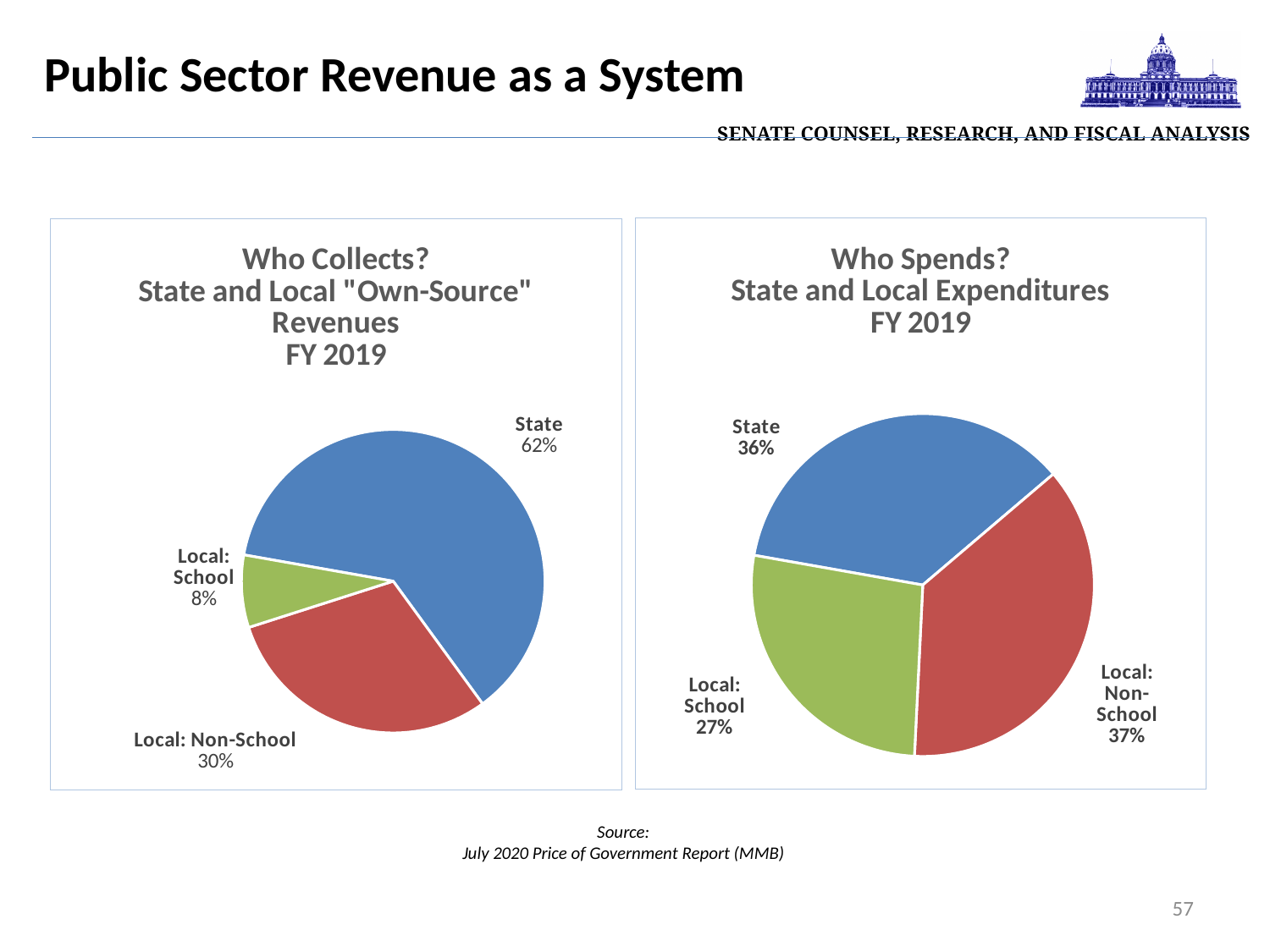
In the 'Who Collects?' pie chart, what share of revenues is collected by Local: Non-School? 30% What type of chart is used on the left side of the slide? pie chart In the 'Who Spends?' pie chart, what share of expenditures is spent by Local: Non-School? 37% In the 'Who Spends?' pie chart, what share of expenditures is spent by Local: School? 27% In the 'Who Spends?' pie chart, is the State share larger or smaller than the Local: School share? larger In the 'Who Collects?' pie chart, which category has the largest share? State In the 'Who Spends?' pie chart, which category has the smallest share? Local: School How many slices does the 'Who Spends?' pie chart have? 3 In the 'Who Collects?' pie chart, what share of revenues is collected by Local: School? 8% In the 'Who Collects?' pie chart, what share of revenues is collected by the State? 62% In the 'Who Collects?' pie chart, which category has the smallest share? Local: School In the 'Who Collects?' pie chart, what is the difference in percentage points between the State share and the Local: Non-School share? 32